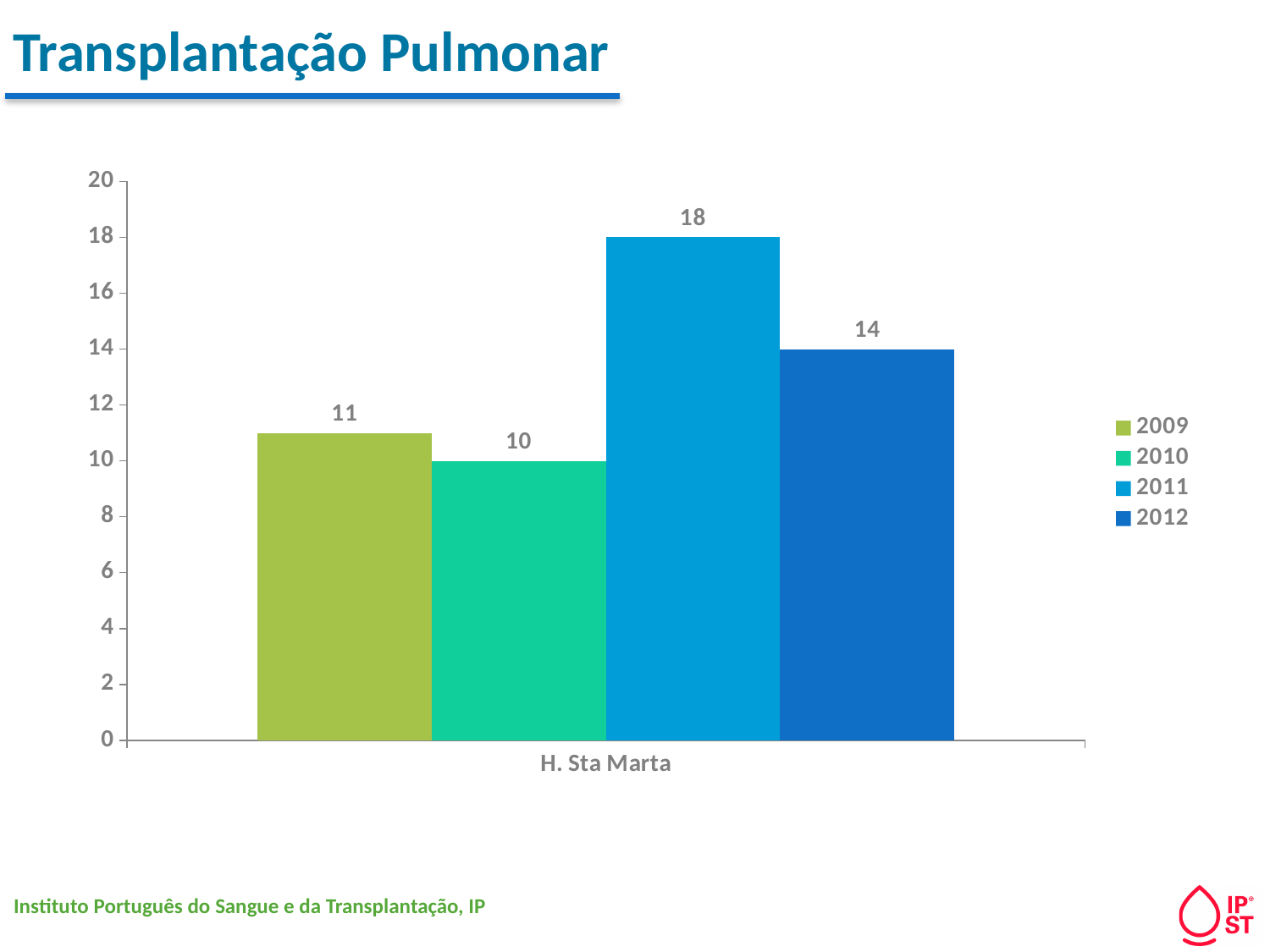
How many series does the legend list? 4 Which year has the highest value at H. Sta Marta? 2011 Which is larger at H. Sta Marta, the value for 2012 or the value for 2009? 2012 What is the value for 2011 at H. Sta Marta? 18 What is the value for 2012 at H. Sta Marta? 14 What is the value for 2009 at H. Sta Marta? 11 What is the difference between the 2011 and 2012 values at H. Sta Marta? 4 What is the title of the slide containing the chart? Transplantação Pulmonar What kind of chart is shown on the slide? bar chart What is the difference between the 2009 and 2010 values at H. Sta Marta? 1 Is the value for 2011 at H. Sta Marta greater or less than 16? greater Which year has the lowest value at H. Sta Marta? 2010